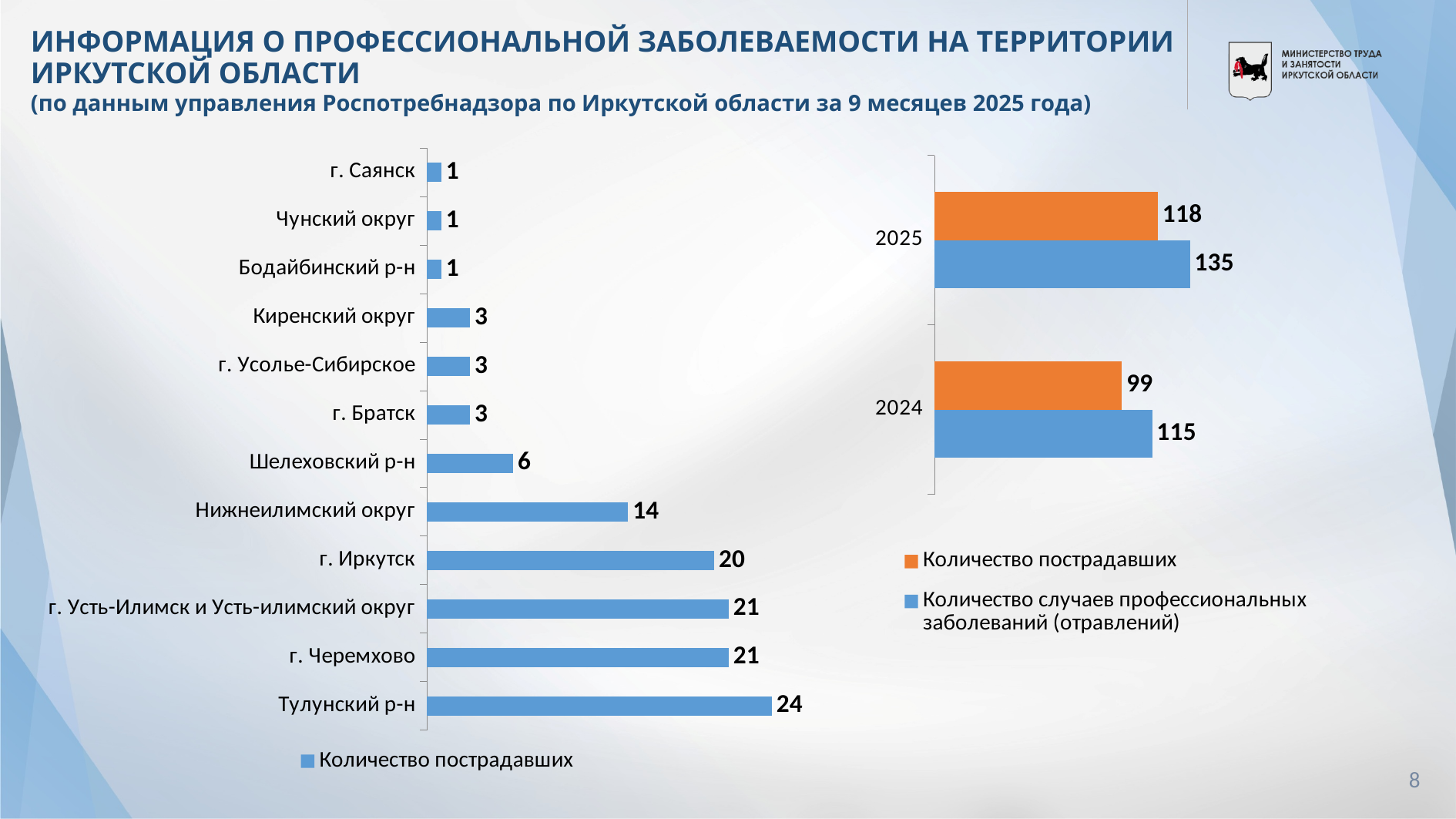
In the left chart, which category has the highest value? Тулунский р-н In the right chart, what is the value of Количество пострадавших for 2025? 118 In the right chart, which colour represents Количество пострадавших? orange In the right chart, what is the difference between Количество случаев профессиональных заболеваний (отравлений) in 2025 and 2024? 20 In the right chart, how many series does the legend list? 2 In the left chart, what is the value for Тулунский р-н? 24 What kind of chart is the left chart? bar chart In the left chart, how many categories are shown? 12 In the left chart, what is the difference between the values for Тулунский р-н and г. Иркутск? 4 In the left chart, what is the value for Нижнеилимский округ? 14 In the right chart, what is the value of Количество случаев профессиональных заболеваний (отравлений) for 2024? 115 In the left chart, which is larger: the value for Шелеховский р-н or the value for г. Братск? Шелеховский р-н